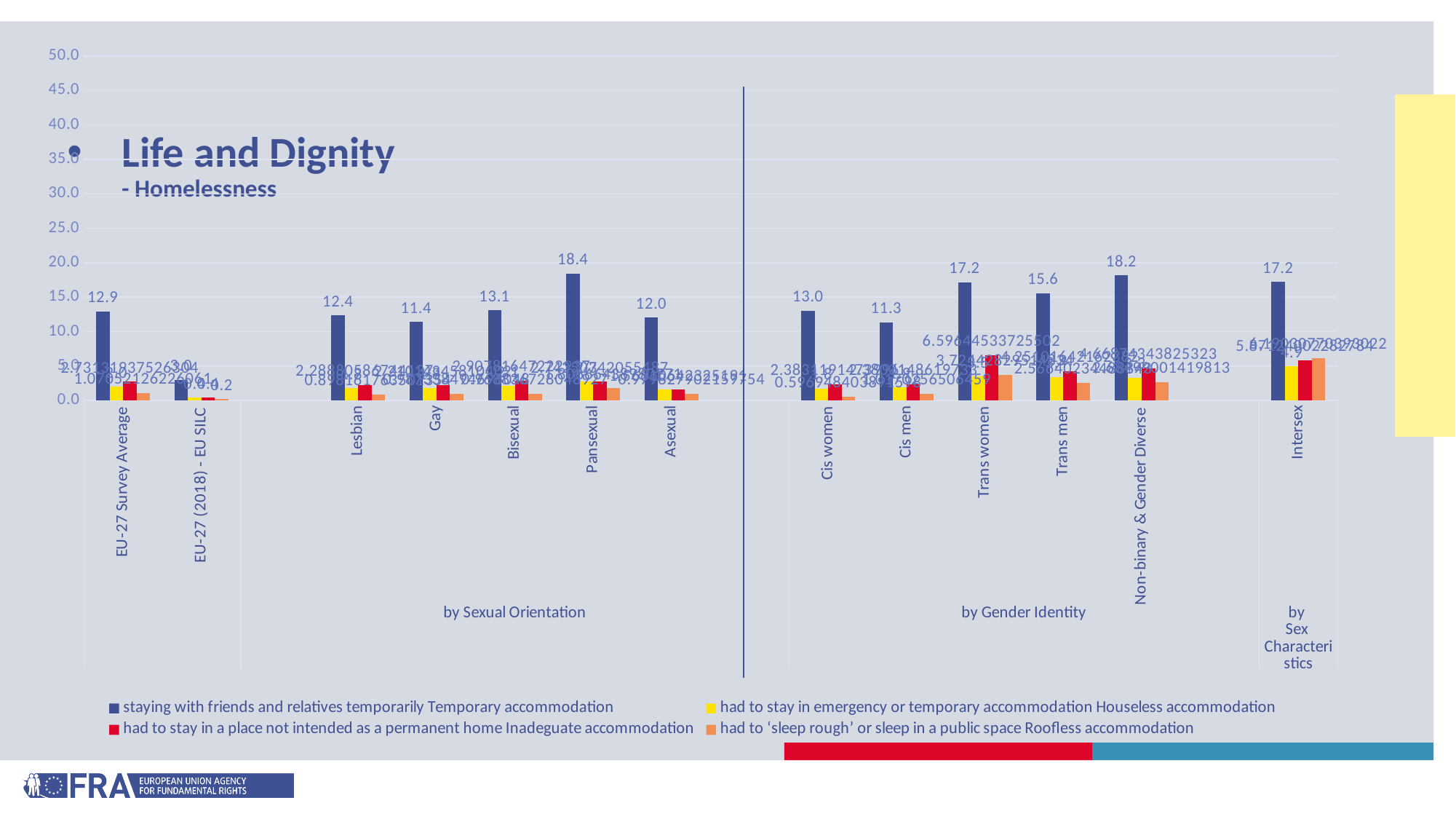
What is the value of the 'staying with friends and relatives temporarily' series for the EU-27 Survey Average? 12.9 Which is larger for the 'staying with friends and relatives temporarily' series: Trans women or Trans men? Trans women What kind of chart is shown on the slide? bar chart Is the 'staying with friends and relatives temporarily' value for Cis men greater or less than 15.0? less Within the 'by Sexual Orientation' group, which category has the lowest value for the 'staying with friends and relatives temporarily' series? Gay What is the value of the 'staying with friends and relatives temporarily' series for Pansexual respondents? 18.4 What is the difference between the 'staying with friends and relatives temporarily' values for Pansexual and Lesbian respondents? 6.0 Which category has the highest value for the 'staying with friends and relatives temporarily' series? Pansexual How many categories are shown along the x axis of the chart? 13 What is the value of the dark blue 'staying with friends and relatives temporarily' bar for Non-binary & Gender Diverse respondents? 18.2 What is the value of the 'staying with friends and relatives temporarily' series for Intersex respondents? 17.2 How many series does the legend list? 4